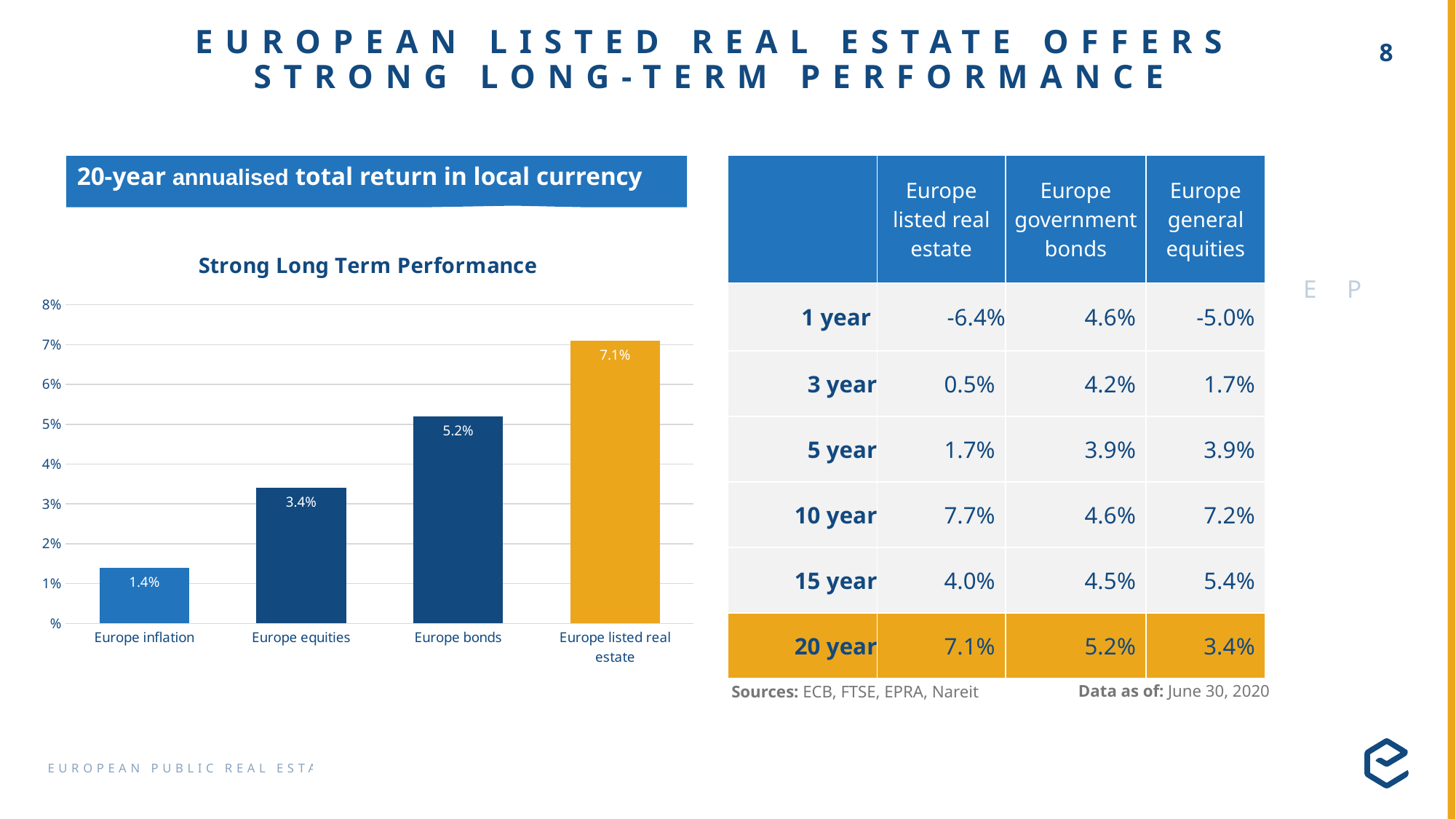
Which bar in the Strong Long Term Performance chart is coloured yellow/orange? Europe listed real estate How many categories are shown in the Strong Long Term Performance chart? 4 What kind of chart is the Strong Long Term Performance chart? bar chart What is the value for Europe equities in the Strong Long Term Performance chart? 3.4% Which category has the lowest value in the Strong Long Term Performance chart? Europe inflation What is the value for Europe bonds in the Strong Long Term Performance chart? 5.2% Which is larger in the Strong Long Term Performance chart: Europe equities or Europe bonds? Europe bonds What is the value for Europe inflation in the Strong Long Term Performance chart? 1.4% What is the value for Europe listed real estate in the Strong Long Term Performance chart? 7.1% What is the difference between the values for Europe listed real estate and Europe bonds in the Strong Long Term Performance chart? 1.9% Which category has the highest value in the Strong Long Term Performance chart? Europe listed real estate Is the value for Europe listed real estate in the Strong Long Term Performance chart greater or less than 6%? greater